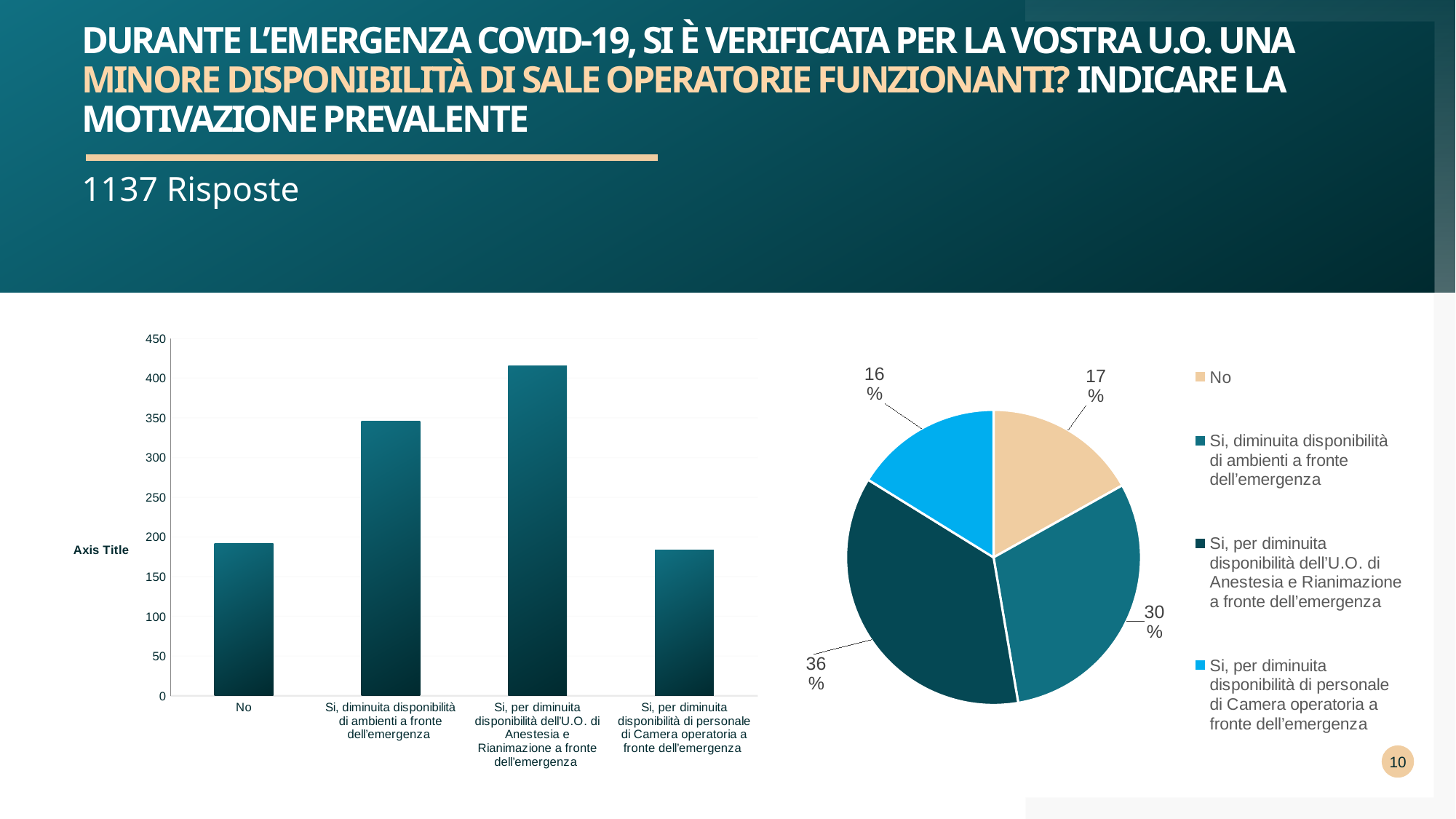
In the pie chart on the right, what share is labelled for 'No'? 17% In the bar chart on the left, how many categories are shown? 4 How many entries does the legend of the pie chart on the right list? 4 In the pie chart on the right, what is the difference in percentage points between the 'Si, diminuita disponibilità di ambienti a fronte dell'emergenza' slice and the 'Si, per diminuita disponibilità di personale di Camera operatoria a fronte dell'emergenza' slice? 14 What type of chart is shown on the right side of the slide? pie chart In the bar chart on the left, which is larger: the bar for 'No' or the bar for 'Si, diminuita disponibilità di ambienti a fronte dell'emergenza'? Si, diminuita disponibilità di ambienti a fronte dell'emergenza What type of chart is shown on the left side of the slide? bar chart In the pie chart on the right, what share is labelled for 'Si, per diminuita disponibilità dell'U.O. di Anestesia e Rianimazione a fronte dell'emergenza'? 36% In the bar chart on the left, is the value for 'No' greater or less than 150? greater In the bar chart on the left, is the value for 'Si, per diminuita disponibilità dell'U.O. di Anestesia e Rianimazione a fronte dell'emergenza' greater or less than 400? greater In the bar chart on the left, is the value for 'Si, diminuita disponibilità di ambienti a fronte dell'emergenza' greater or less than 300? greater In the bar chart on the left, which category has the highest bar? Si, per diminuita disponibilità dell'U.O. di Anestesia e Rianimazione a fronte dell'emergenza